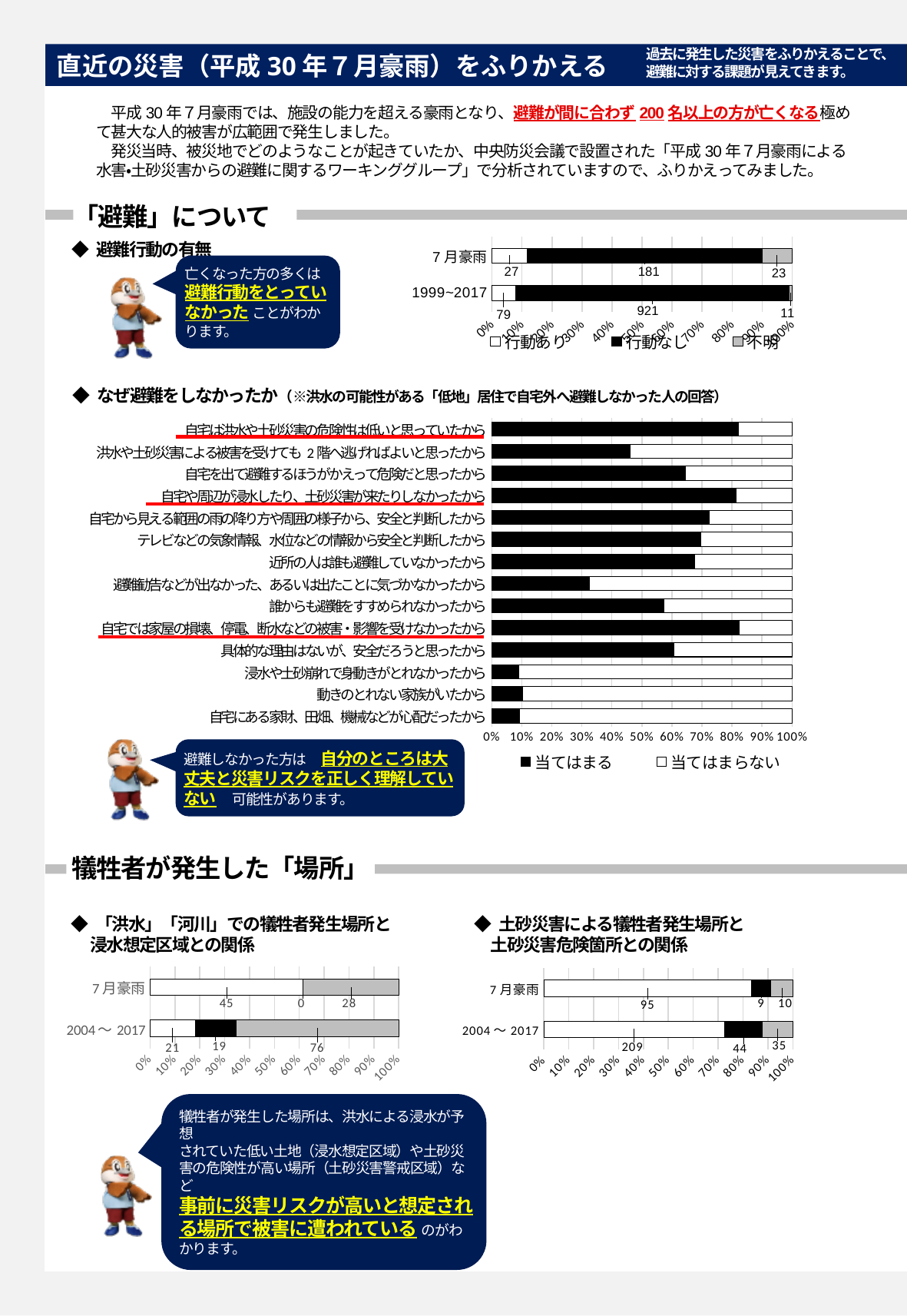
How many categories (reasons) are plotted in the なぜ避難をしなかったか chart? 14 How many series does the legend of the 避難行動の有無 chart list? 3 In the 土砂災害による犠牲者発生場所と土砂災害危険箇所との関係 chart, what is the first (leftmost) value labelled on the 2004～2017 bar? 209 In the 避難行動の有無 chart, what is the value for 行動あり in the 1999~2017 bar? 79 In the なぜ避難をしなかったか chart, is the 当てはまる share for 自宅は洪水や土砂災害の危険性は低いと思っていたから greater or less than 70%? greater In the なぜ避難をしなかったか chart, which has the larger 当てはまる share: 自宅は洪水や土砂災害の危険性は低いと思っていたから or 避難勧告などが出なかった、あるいは出たことに気づかなかったから? 自宅は洪水や土砂災害の危険性は低いと思っていたから In the 「洪水」「河川」での犠牲者発生場所と浸水想定区域との関係 chart, what is the first (leftmost) value labelled on the 7月豪雨 bar? 45 In the 土砂災害による犠牲者発生場所と土砂災害危険箇所との関係 chart, what is the total of the 7月豪雨 bar (95 + 9 + 10)? 114 What kind of chart is the なぜ避難をしなかったか chart? bar chart In the 避難行動の有無 chart, what is the value for 行動なし in the 7月豪雨 bar? 181 In the なぜ避難をしなかったか chart, is the 当てはまる share for 浸水や土砂崩れで身動きがとれなかったから greater or less than 20%? less In the 避難行動の有無 chart, what is the total of the 7月豪雨 bar (27 + 181 + 23)? 231